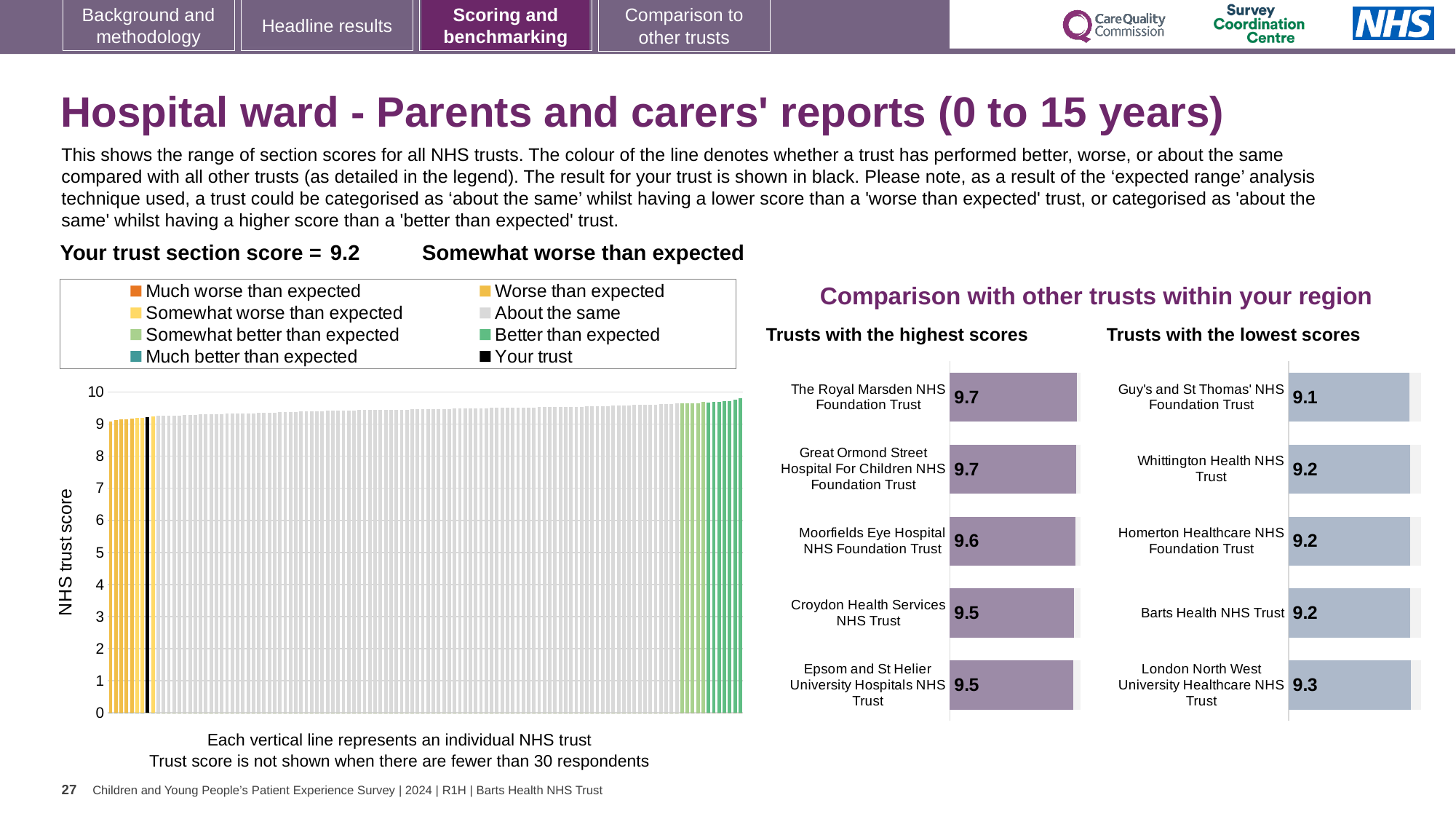
In the large chart on the left, do the trust scores rise or fall from left to right along the x axis? Rise In the 'Trusts with the highest scores' chart, what is the score for The Royal Marsden NHS Foundation Trust? 9.7 In the 'Trusts with the lowest scores' chart, which trust has the lowest score? Guy's and St Thomas' NHS Foundation Trust How many trusts are shown in the 'Trusts with the lowest scores' chart? 5 How many entries does the legend above the large chart on the left list? 8 In the 'Trusts with the lowest scores' chart, which trust has the highest score? London North West University Healthcare NHS Trust In the 'Trusts with the lowest scores' chart, what is the score for Guy's and St Thomas' NHS Foundation Trust? 9.1 In the 'Trusts with the highest scores' chart, what is the difference between the scores of The Royal Marsden NHS Foundation Trust and Croydon Health Services NHS Trust? 0.2 In the 'Trusts with the highest scores' chart, what is the score for Moorfields Eye Hospital NHS Foundation Trust? 9.6 In the 'Trusts with the lowest scores' chart, which has the larger score: Guy's and St Thomas' NHS Foundation Trust or London North West University Healthcare NHS Trust? London North West University Healthcare NHS Trust How many trusts are shown in the 'Trusts with the highest scores' chart? 5 What kind of chart is the large chart on the left with the 'NHS trust score' axis? Bar chart